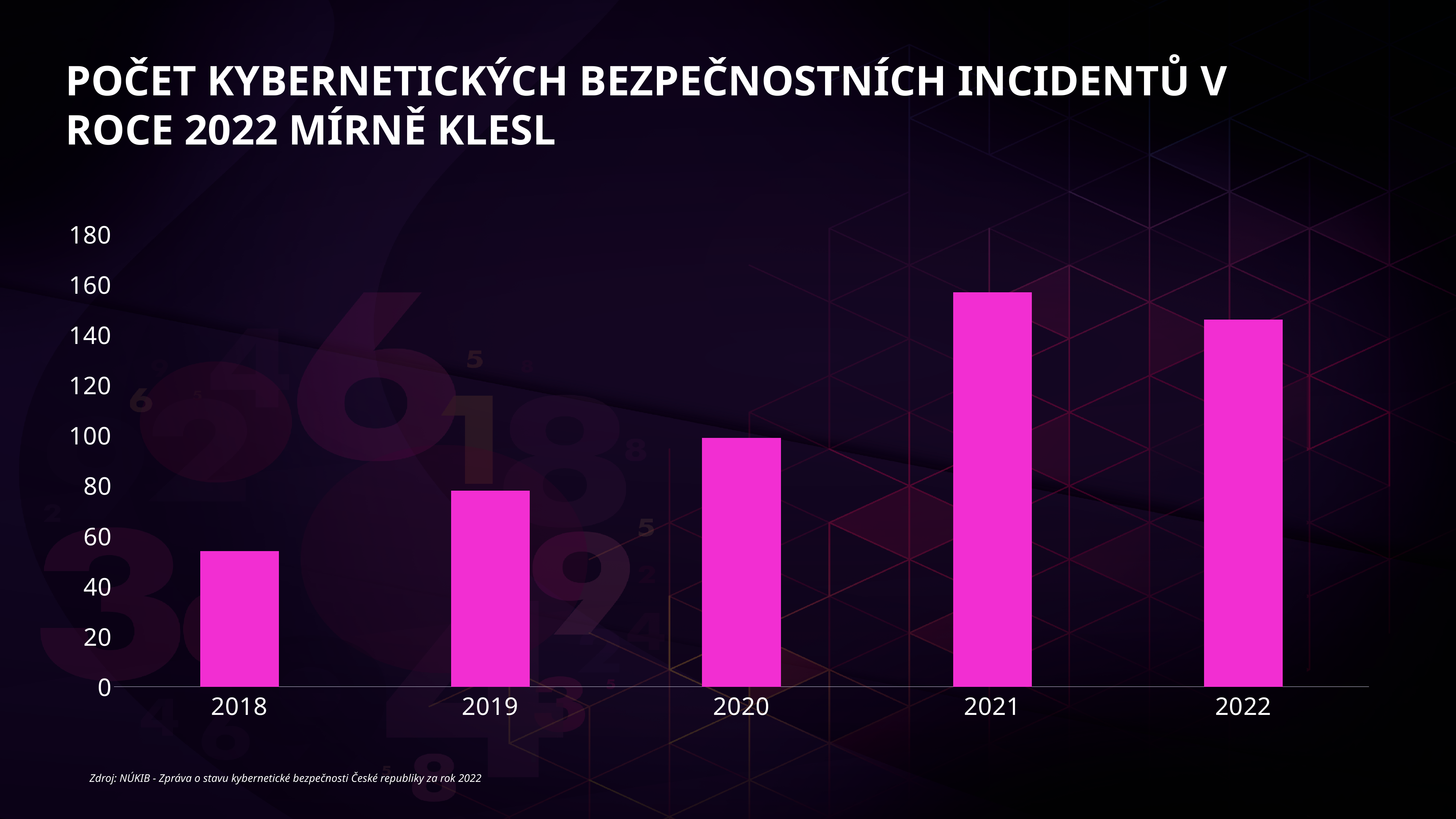
What kind of chart is shown on the slide? bar chart Is the value for 2019 greater or less than 60? greater Is the value for 2021 greater or less than 140? greater How many years are shown on the x axis of the chart? 5 Do the values rise or fall from 2018 to 2021? rise Is the value for 2022 greater or less than 160? less Which year has the larger value, 2018 or 2019? 2019 Which year has the highest number of incidents? 2021 Which year has the larger value, 2021 or 2022? 2021 What is the title of the slide? POČET KYBERNETICKÝCH BEZPEČNOSTNÍCH INCIDENTŮ V ROCE 2022 MÍRNĚ KLESL Which year has the lowest number of incidents? 2018